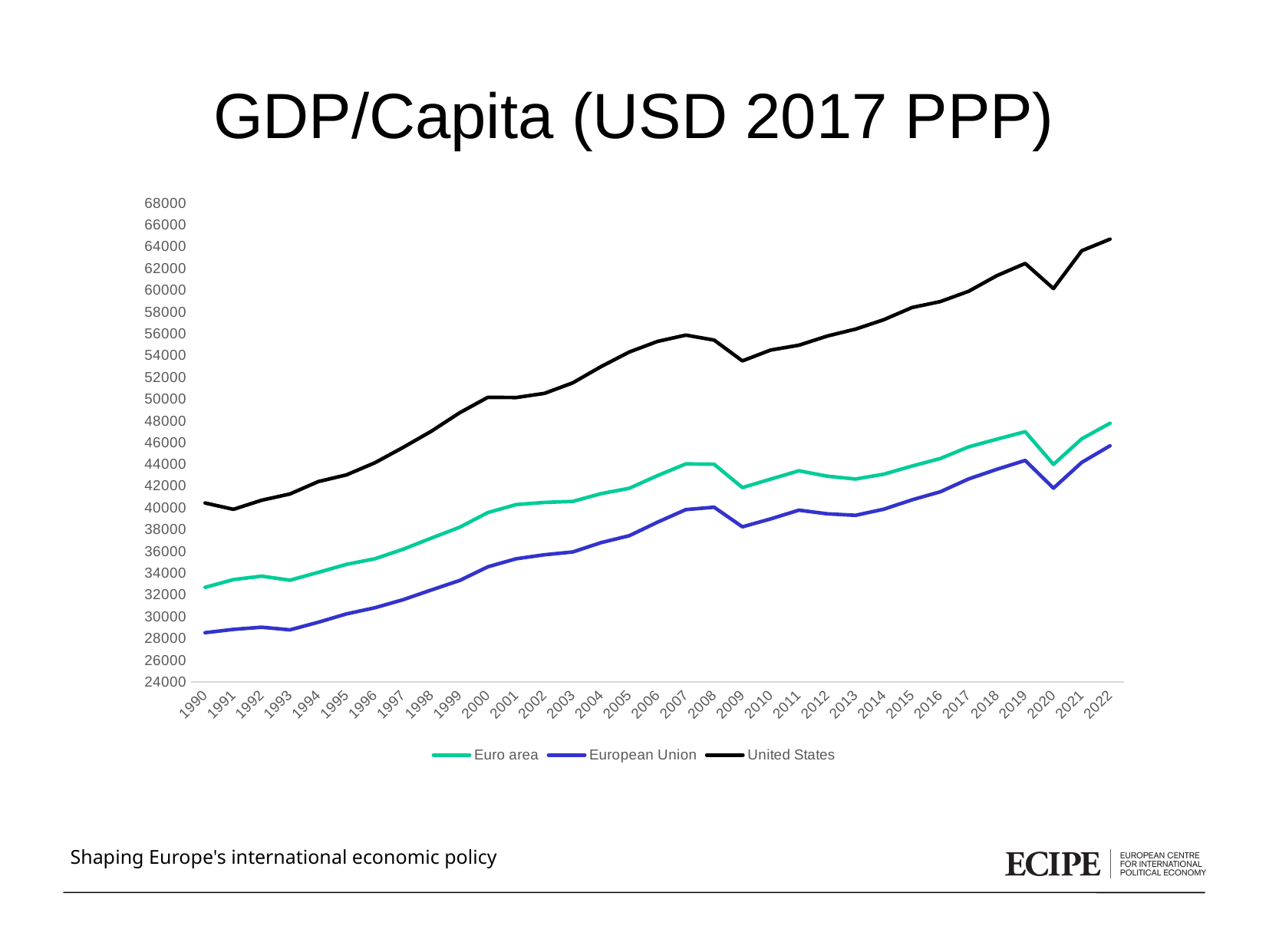
Which series has the highest value in 2022? United States Is the value for European Union in 2020 greater or less than 44000? less Does the United States series generally rise or fall from 1990 to 2022? Rise Which is larger in 2010, the value for Euro area or the value for European Union? Euro area How many series does the legend list? 3 What is the title of the chart? GDP/Capita (USD 2017 PPP) What kind of chart is shown on the slide? Line chart How many years are plotted along the x axis? 33 Is the value for European Union in 1990 greater or less than 30000? less Which series is drawn in black? United States Is the value for United States in 2022 greater or less than 60000? greater Which series has the lowest value in 1990? European Union